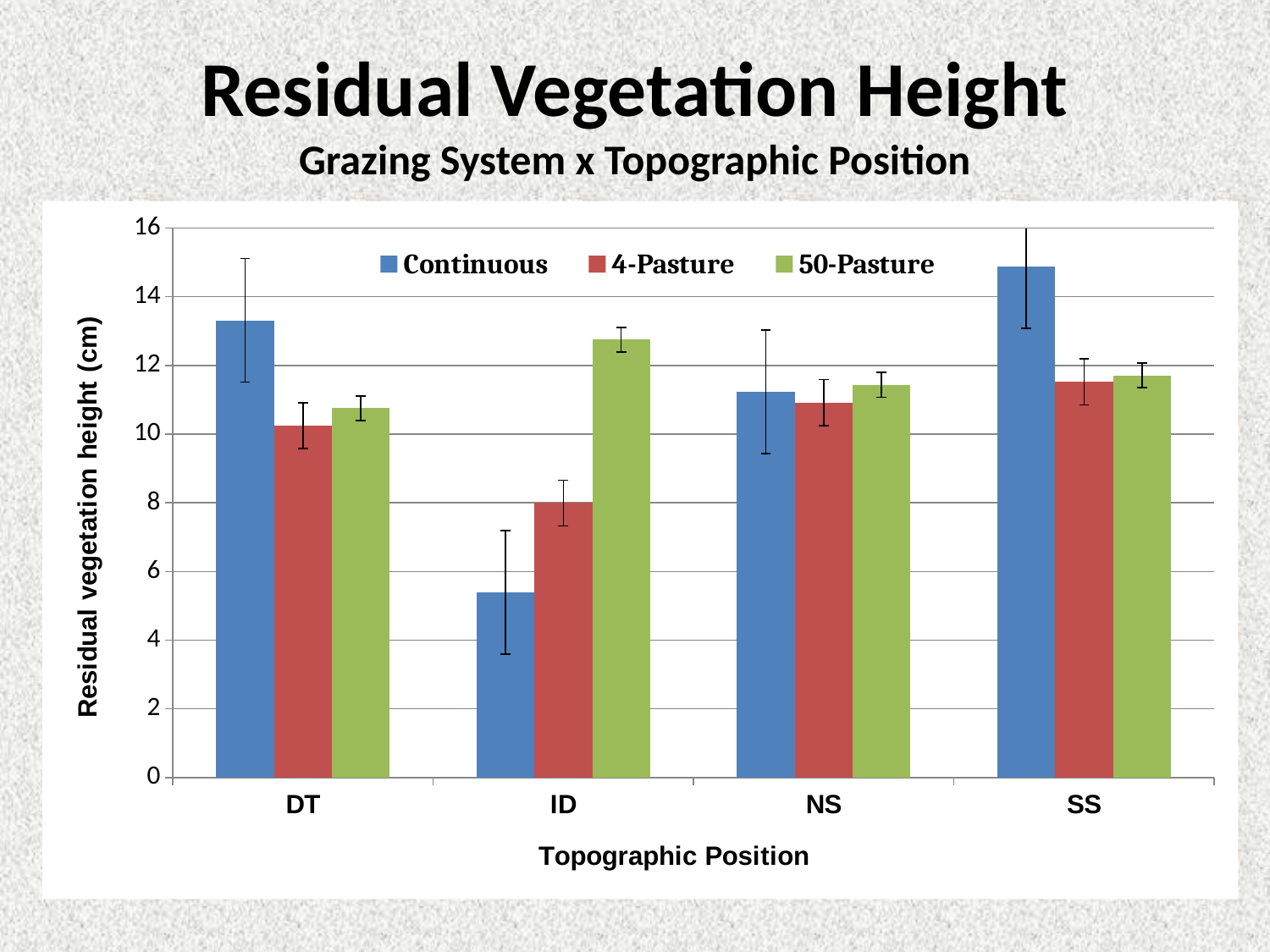
At DT, which is larger: the Continuous bar or the 4-Pasture bar? Continuous At which topographic position is the Continuous bar highest? SS What is the label of the vertical axis? Residual vegetation height (cm) Is the Continuous value at SS greater or less than 14? greater How many series does the legend list? 3 Is the 50-Pasture value at ID greater or less than 12? greater How many topographic positions are shown on the x axis? 4 Is the Continuous value at ID greater or less than 6? less At which topographic position is the Continuous bar lowest? ID What kind of chart is shown on the slide? Bar chart At ID, which is larger: the Continuous bar or the 50-Pasture bar? 50-Pasture